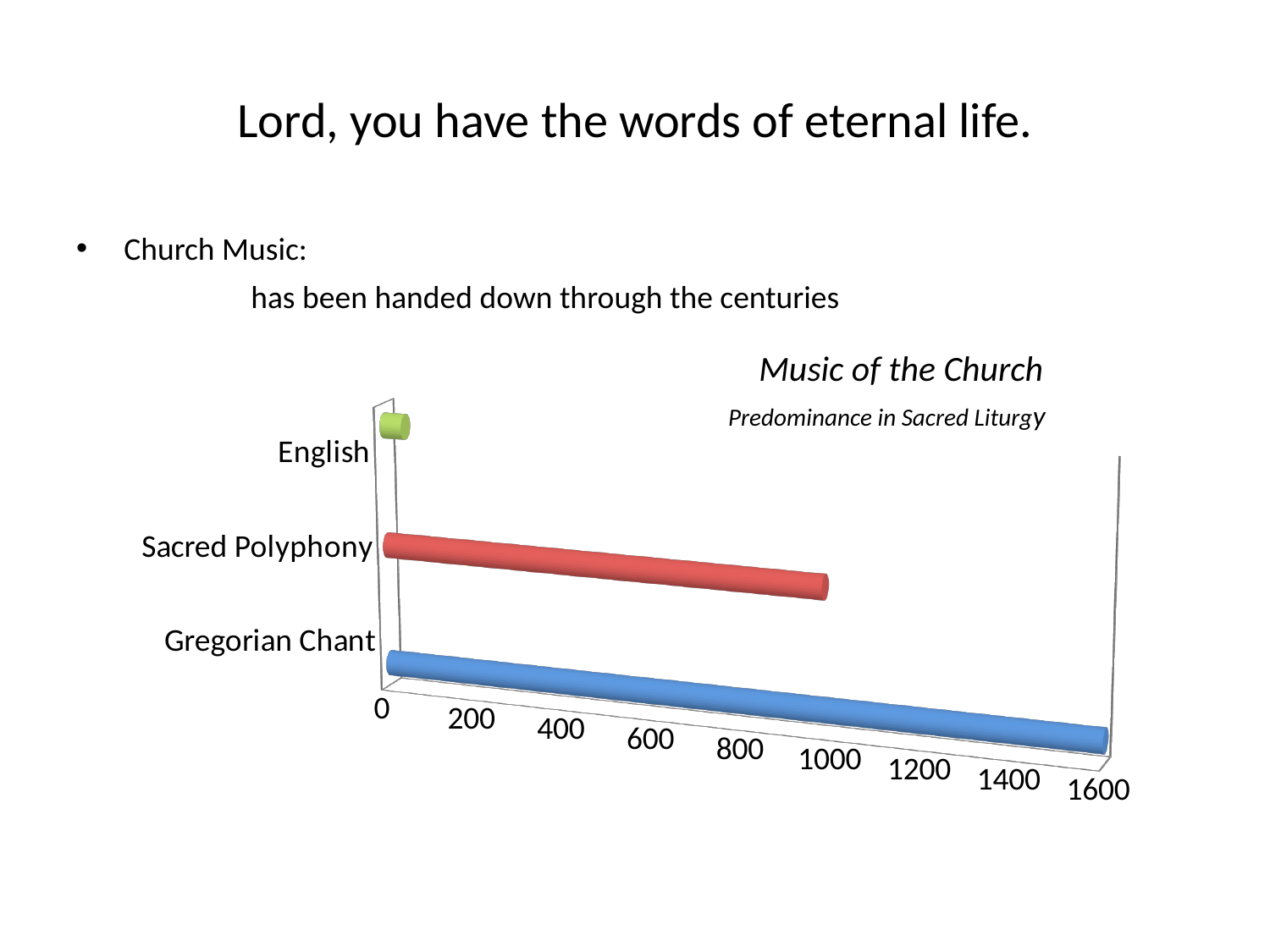
What kind of chart is shown on the slide? bar chart Is the value for Gregorian Chant greater or less than 1000? greater Which category has the highest value? Gregorian Chant What subtitle appears under the chart title? Predominance in Sacred Liturgy Which is larger, the value for Gregorian Chant or the value for Sacred Polyphony? Gregorian Chant Is the value for English greater or less than 200? less What is the title of the chart? Music of the Church Which is larger, the value for Sacred Polyphony or the value for English? Sacred Polyphony Is the value for Sacred Polyphony greater or less than 400? greater Which category has the lowest value? English How many categories are plotted in the chart? 3